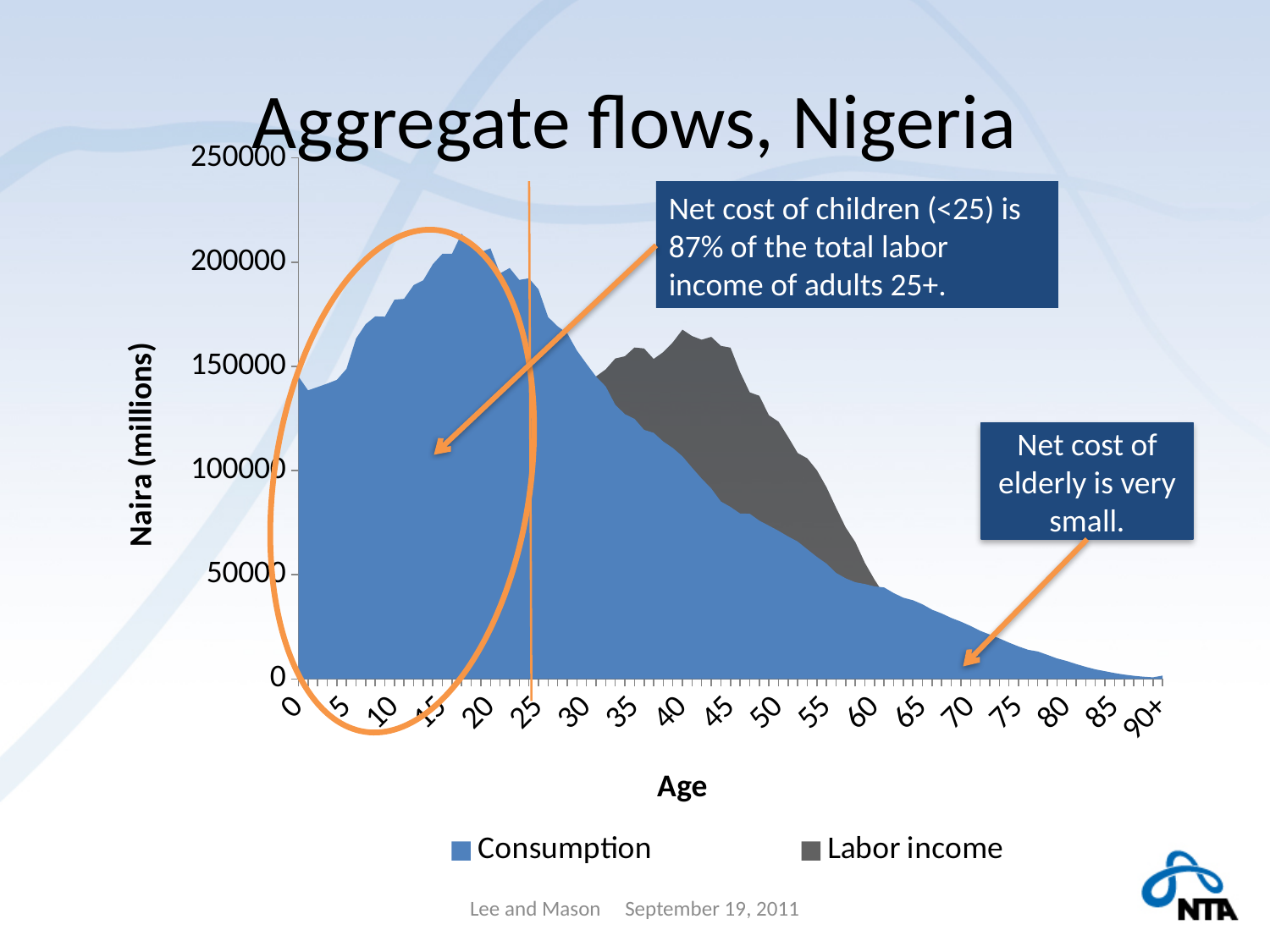
Is the value of Consumption at age 20 greater or less than 150000? greater At age 40, which is larger, Consumption or Labor income? Labor income Is the value of Consumption at age 0 greater or less than 100000? greater Does Consumption rise or fall from age 60 to age 90+? Fall What kind of chart is shown on the slide? Area chart Is the peak value of Labor income greater or less than 150000? greater What is the label of the vertical axis? Naira (millions) At age 10, which is larger, Consumption or Labor income? Consumption How many series does the legend list? 2 What is the title of the chart? Aggregate flows, Nigeria